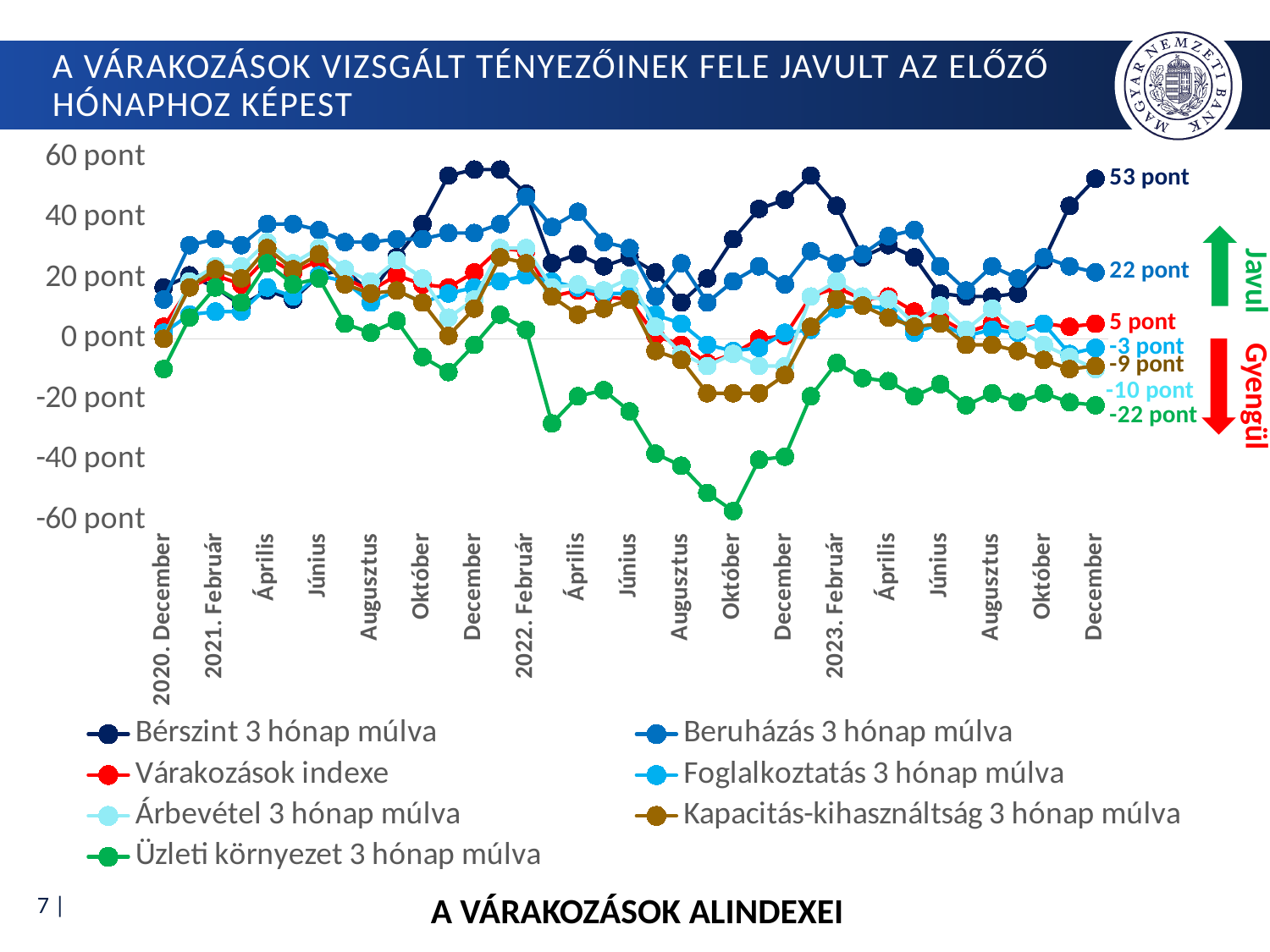
How many series does the legend list? 7 At the last point, which is larger: Foglalkoztatás 3 hónap múlva or Árbevétel 3 hónap múlva? Foglalkoztatás 3 hónap múlva What is the value of Kapacitás-kihasználtság 3 hónap múlva at the last point (2023 December)? -9 pont What is the value of Beruházás 3 hónap múlva at the last point (2023 December)? 22 pont What kind of chart is shown on the slide? line chart What is the value of Bérszint 3 hónap múlva at the last point (2023 December)? 53 pont What is the value of Várakozások indexe at the last point (2023 December)? 5 pont Which series has the lowest value at the last point (2023 December)? Üzleti környezet 3 hónap múlva What is the difference between the final values of Bérszint 3 hónap múlva (53 pont) and Beruházás 3 hónap múlva (22 pont)? 31 pont Which series has the highest value at the last point (2023 December)? Bérszint 3 hónap múlva Is the value of Üzleti környezet 3 hónap múlva in 2022 Október greater or less than -40 pont? less What is the value of Üzleti környezet 3 hónap múlva at the last point (2023 December)? -22 pont